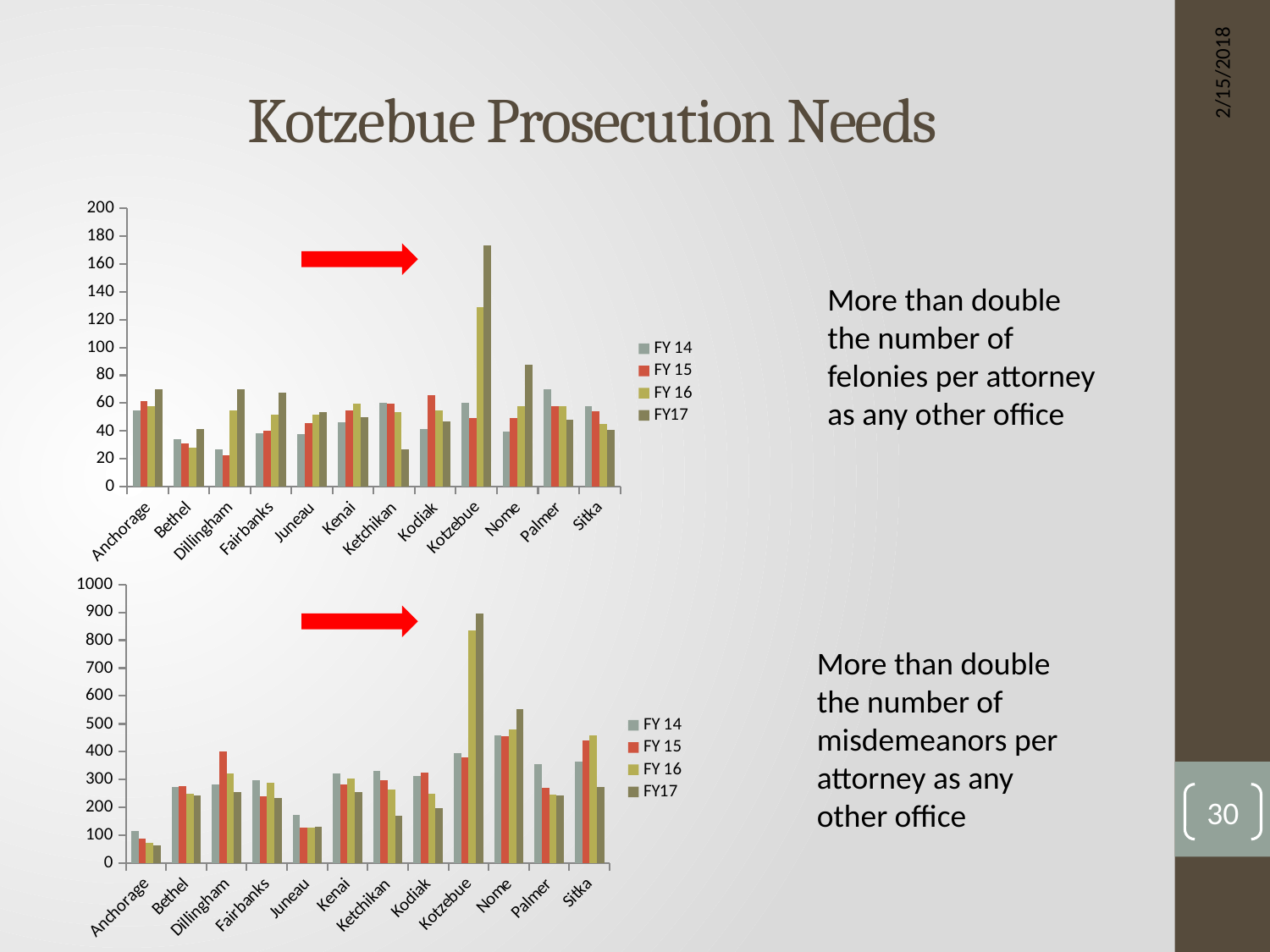
In the top chart, which office has the lowest FY17 value? Ketchikan In the bottom chart, which office has the lowest FY17 value? Anchorage In the top chart, which office has the highest FY17 value? Kotzebue How many series does the legend of the top chart list? 4 In the top chart, is the FY17 value for Kotzebue greater or less than 160? greater In the top chart, which is larger, the FY17 value for Kotzebue or the FY17 value for Nome? Kotzebue How many offices (categories) are shown on the x axis of the bottom chart? 12 What kind of chart is the top chart on the slide? bar chart In the bottom chart, is the FY17 value for Kotzebue greater or less than 800? greater In the bottom chart, is the FY15 value for Juneau greater or less than 200? less In the bottom chart, which office has the highest FY17 value? Kotzebue What are the legend entries of the bottom chart? FY 14, FY 15, FY 16, FY17